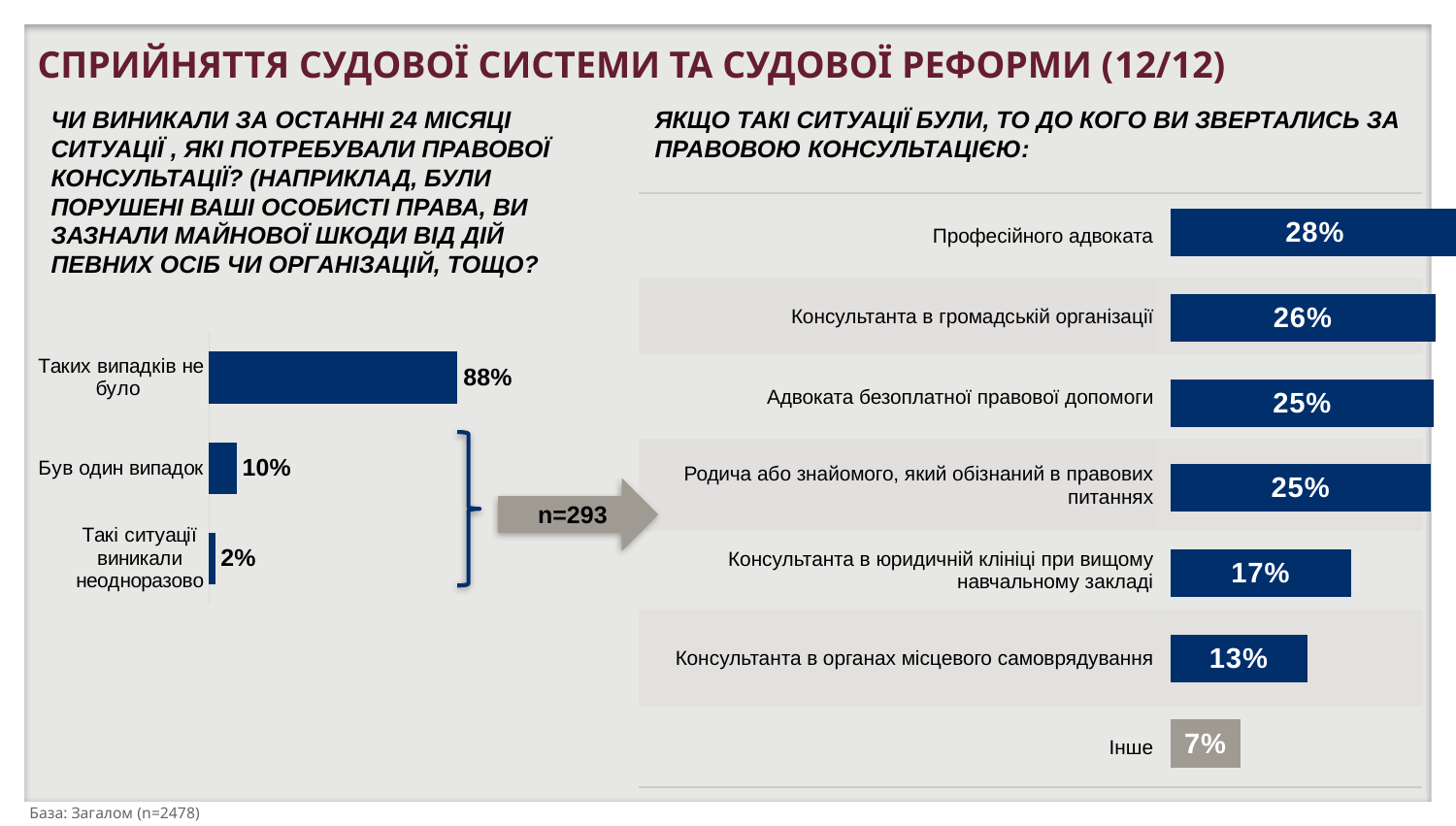
In the right chart, which category has the highest value? Професійного адвоката In the right chart, which category has the lowest value? Інше In the right chart, what is the value for "Професійного адвоката"? 28% In the right chart, how many categories are shown? 7 In the left chart, which category has the lowest value? Такі ситуації виникали неодноразово In the right chart, what is the value for "Консультанта в юридичній клініці при вищому навчальному закладі"? 17% In the left chart, what is the value for "Був один випадок"? 10% In the right chart, which is larger: the value for "Консультанта в громадській організації" or the value for "Консультанта в органах місцевого самоврядування"? Консультанта в громадській організації What type of chart is the right chart? Bar chart In the left chart, how many categories are shown? 3 In the left chart, what is the value for "Таких випадків не було"? 88% In the left chart, what is the difference between the values for "Таких випадків не було" and "Був один випадок"? 78%